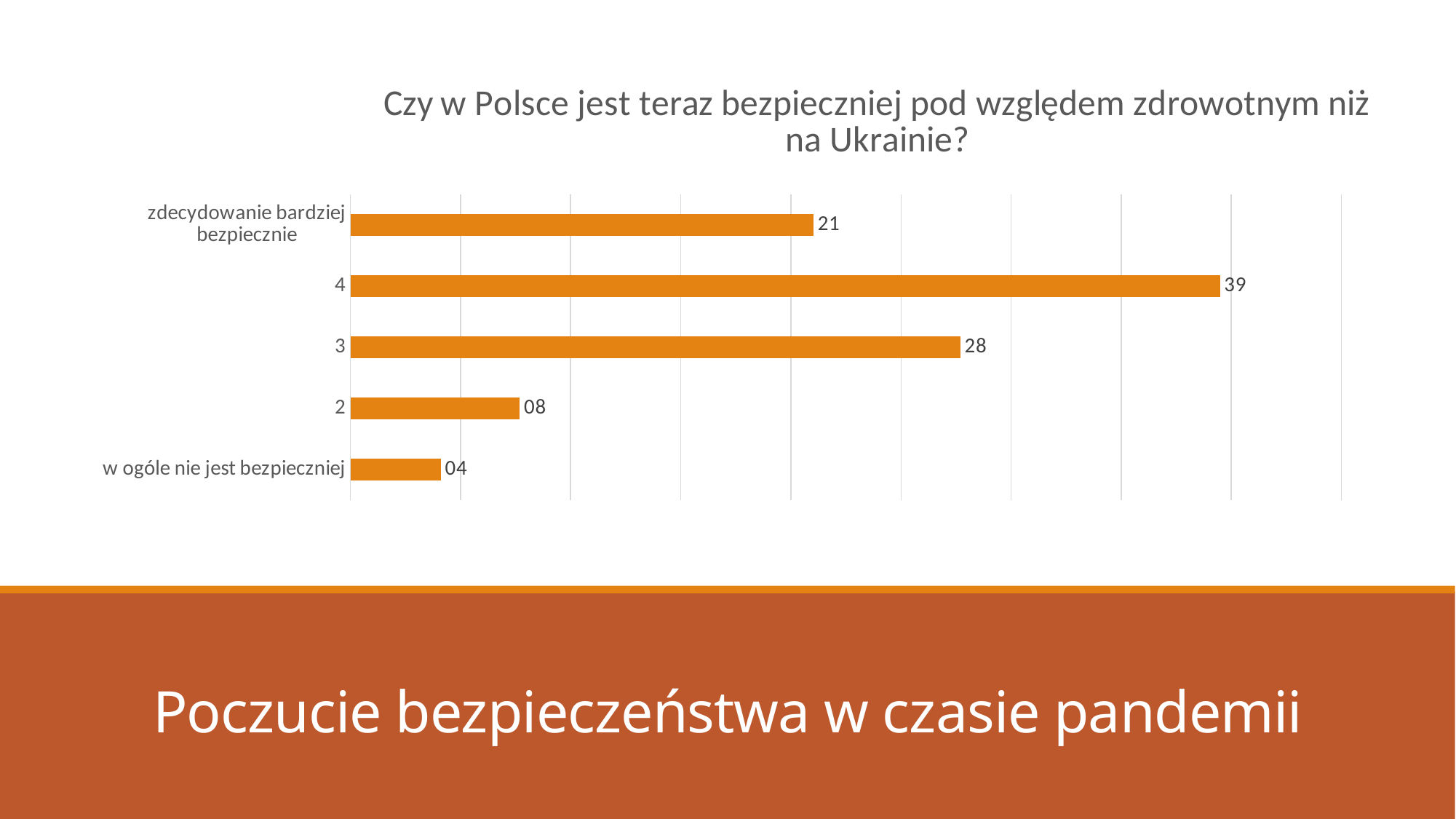
Which category has the lowest value? w ogóle nie jest bezpieczniej What is the value for "zdecydowanie bardziej bezpiecznie"? 21 What is the value for category "4"? 39 How many categories are shown in the chart? 5 What is the value for "w ogóle nie jest bezpieczniej"? 04 What is the value for category "2"? 08 What kind of chart is shown on the slide? bar chart What is the difference between the values for category "4" and category "3"? 11 What is the value for category "3"? 28 Which is larger: the value for "zdecydowanie bardziej bezpiecznie" or the value for category "2"? zdecydowanie bardziej bezpiecznie Which category has the highest value? 4 What is the title of the chart? Czy w Polsce jest teraz bezpieczniej pod względem zdrowotnym niż na Ukrainie?